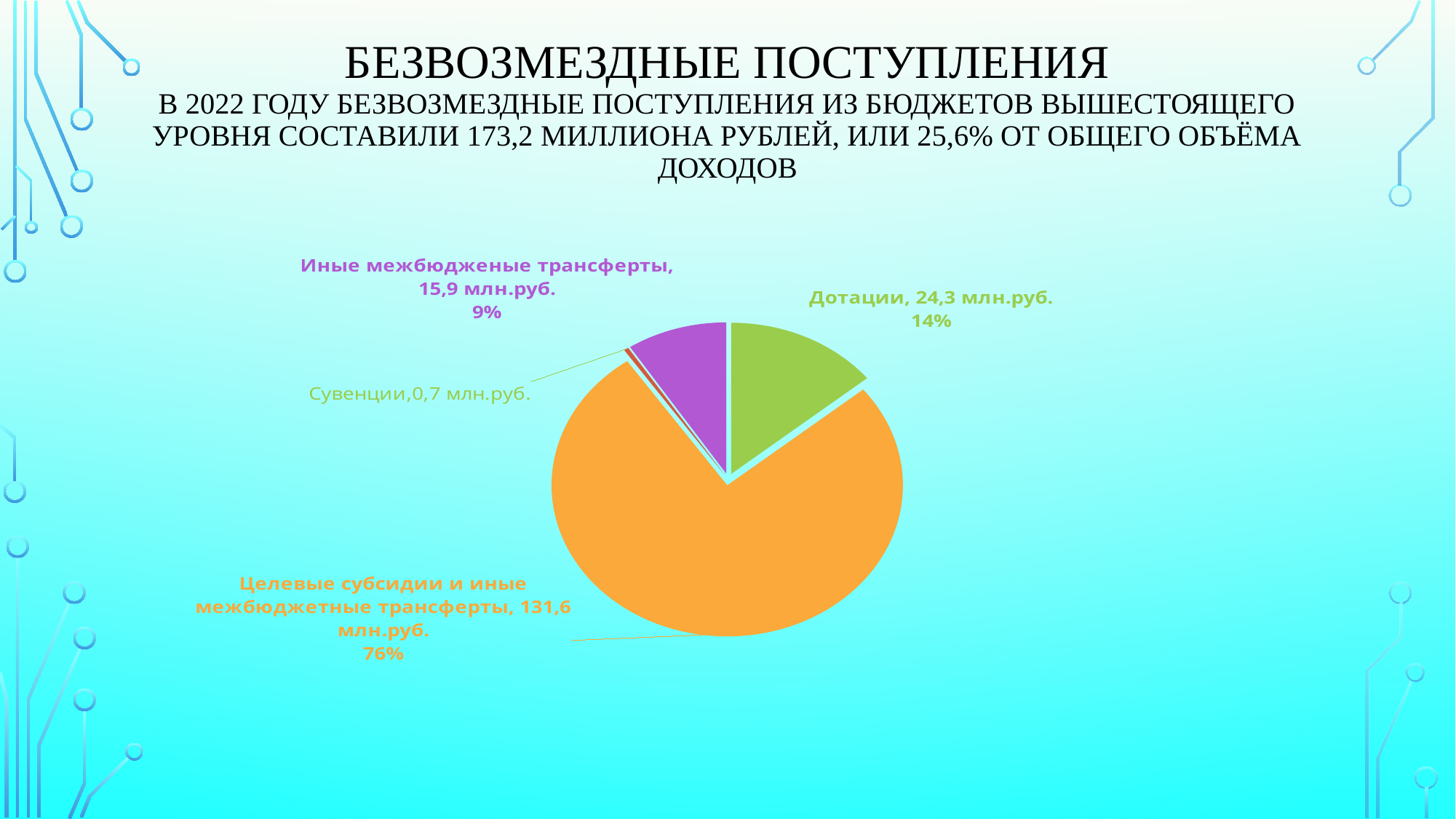
How many slices does the pie chart have? 4 Which category has the largest slice of the pie? Целевые субсидии и иные межбюджетные трансферты What is the value for Дотации? 24,3 млн.руб. What kind of chart is shown on the slide? pie chart What is the difference between the values for Дотации and Иные межбюдженые трансферты? 8,4 млн.руб. What is the value for Иные межбюдженые трансферты? 15,9 млн.руб. Which category has the smallest slice of the pie? Сувенции What is the value for Целевые субсидии и иные межбюджетные трансферты? 131,6 млн.руб. Which is larger, the value for Дотации or the value for Иные межбюдженые трансферты? Дотации What share of the pie does Дотации represent? 14% What is the value for Субвенции? 0,7 млн.руб. What share of the pie does Целевые субсидии и иные межбюджетные трансферты represent? 76%